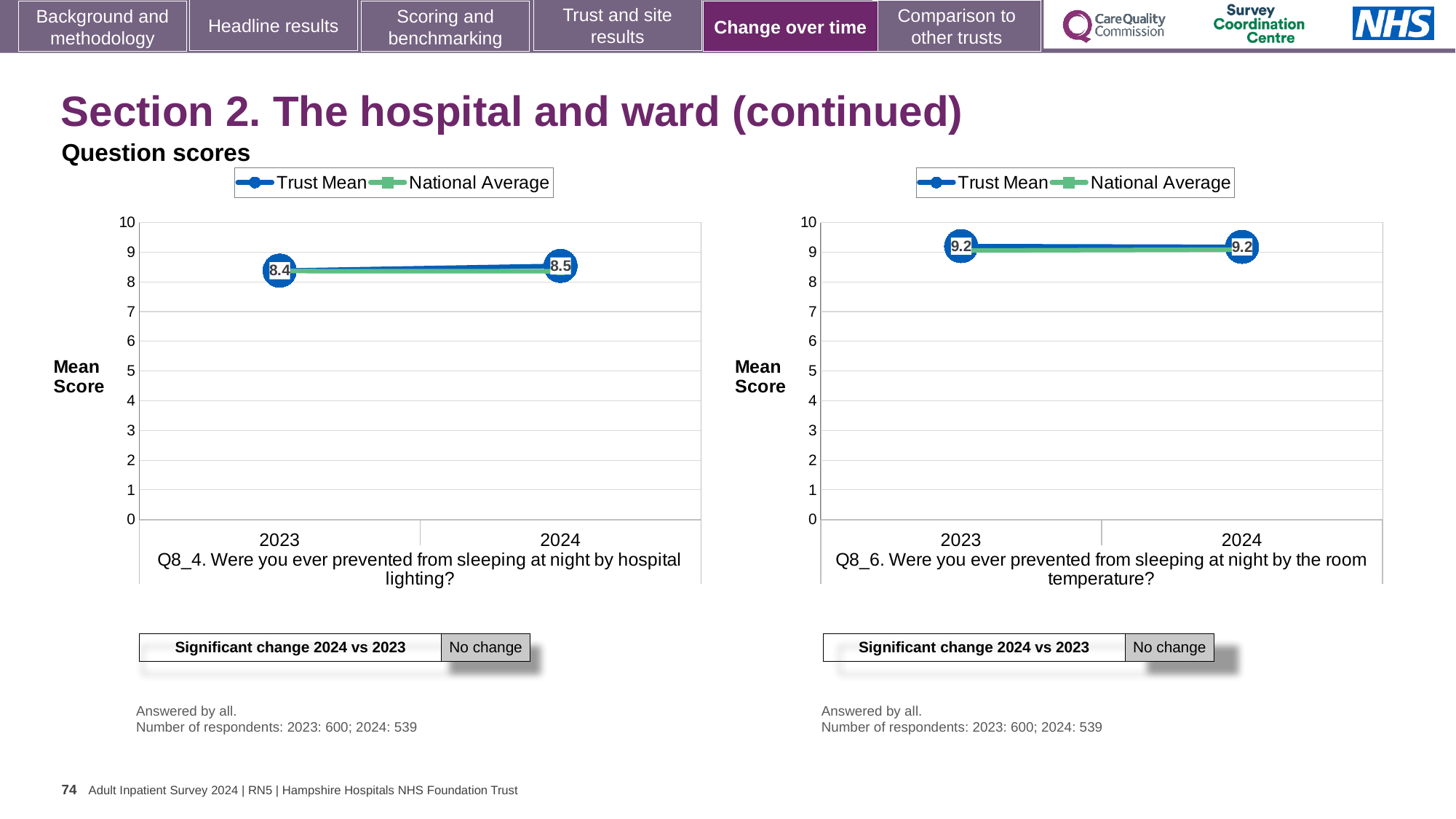
What is the label of the y axis on the Q8_6 chart (right)? Mean Score In the Q8_4 chart (left), what is the Trust Mean for 2024? 8.5 In the Q8_4 chart (left), is the National Average for 2023 greater or less than 9? less How many years are plotted on the x axis of the Q8_4 chart (left)? 2 In the Q8_4 chart (left), what is the Trust Mean for 2023? 8.4 What kind of chart is the Q8_4 chart (left)? line chart How many series does the legend of the Q8_6 chart (right) list? 2 In the Q8_4 chart (left), what is the difference between the Trust Mean for 2024 and 2023? 0.1 In the Q8_6 chart (right), is the National Average for 2024 greater or less than 8? greater In the Q8_6 chart (right), does the Trust Mean rise, fall or stay the same from 2023 to 2024? stays the same In the Q8_4 chart (left), which year has the higher Trust Mean, 2023 or 2024? 2024 In the Q8_6 chart (right), what is the Trust Mean for 2024? 9.2